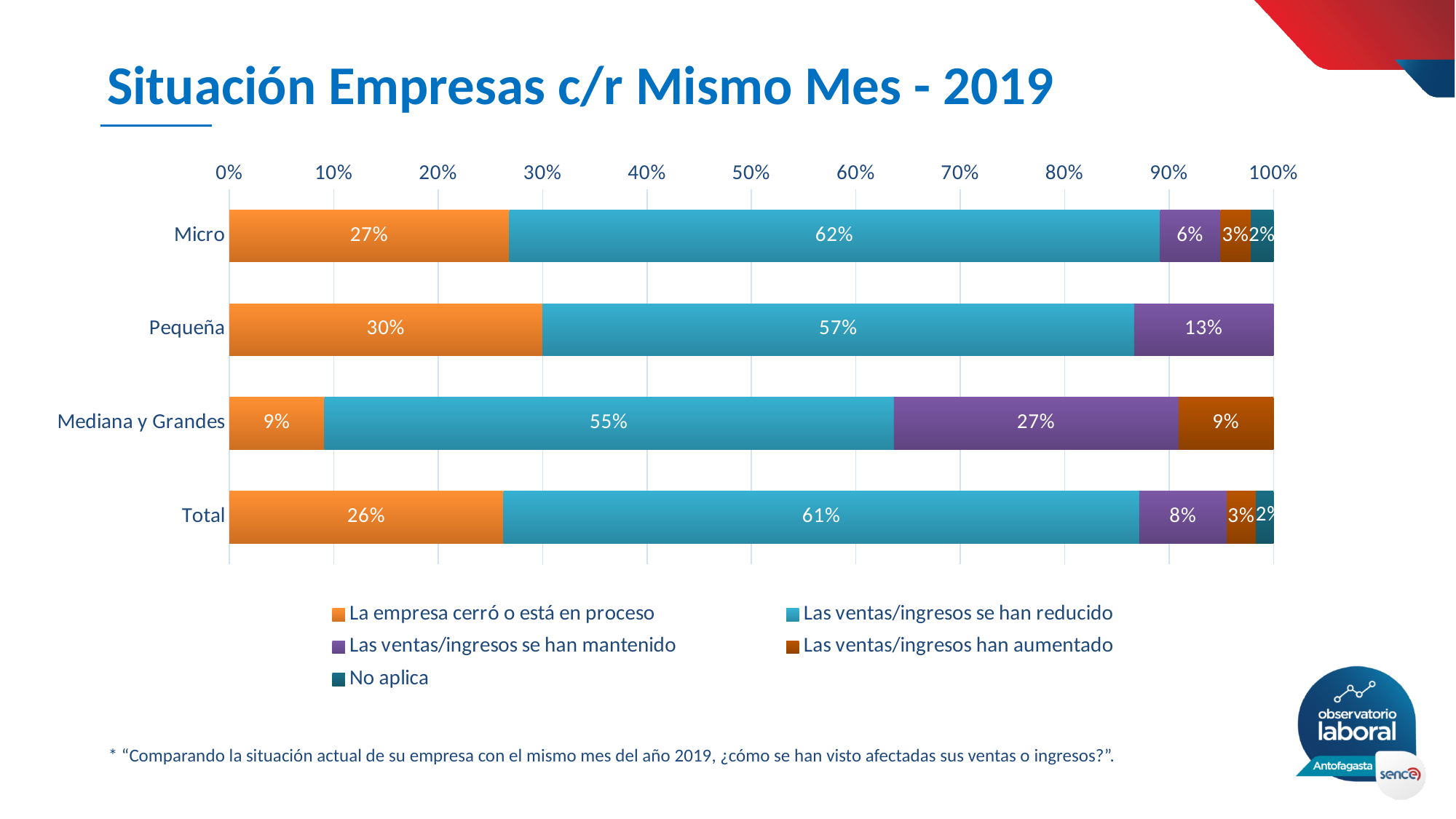
Which category has the highest value for 'Las ventas/ingresos se han reducido'? Micro What is the difference between the 'La empresa cerró o está en proceso' values for Pequeña and Micro? 3% What is the value of 'La empresa cerró o está en proceso' for Micro? 27% What type of chart is shown on the slide? Stacked bar chart What is the value of 'Las ventas/ingresos se han mantenido' for Mediana y Grandes? 27% Which category has the lowest value for 'La empresa cerró o está en proceso'? Mediana y Grandes What is the title of the chart on the slide? Situación Empresas c/r Mismo Mes - 2019 How many series does the legend list? 5 What is the value of 'Las ventas/ingresos se han reducido' for Pequeña? 57% What is the value of 'Las ventas/ingresos han aumentado' for Total? 3% How many categories are shown on the vertical axis of the chart? 4 Which is larger: 'Las ventas/ingresos se han mantenido' for Pequeña or for Total? Pequeña